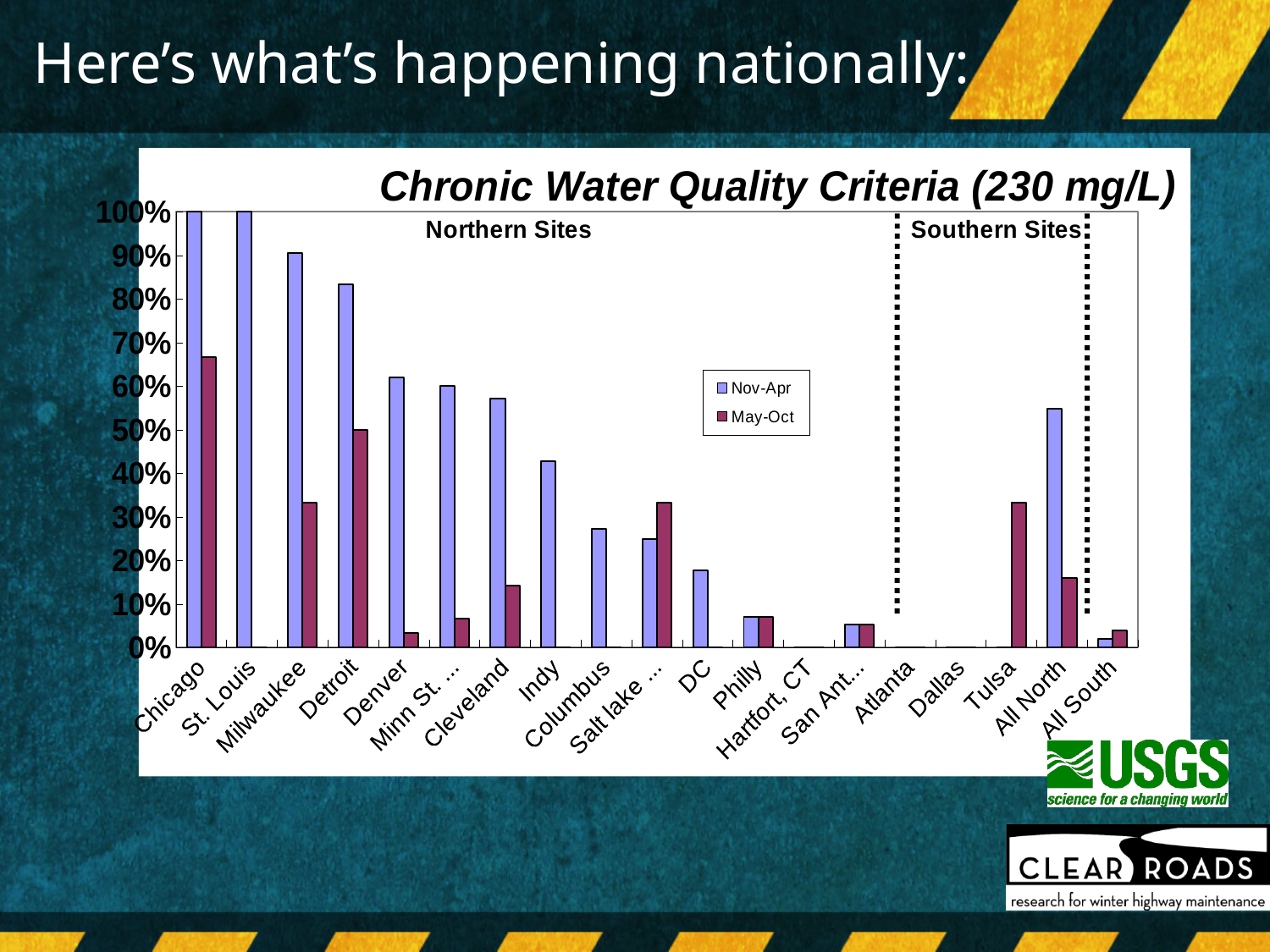
How many categories are shown along the x axis? 19 Which is larger, the May-Oct value for Chicago or the May-Oct value for Milwaukee? Chicago What kind of chart is shown on the slide? bar chart For Salt lake, which series has the larger value, Nov-Apr or May-Oct? May-Oct What is the Nov-Apr value for Chicago? 100% What are the two series named in the legend? Nov-Apr and May-Oct Which category has the highest May-Oct value? Chicago What is the title of the chart? Chronic Water Quality Criteria (230 mg/L) Is the Nov-Apr value for All North greater or less than 50%? greater Is the Nov-Apr value for Columbus greater or less than 30%? less Is the Nov-Apr value for Detroit greater or less than 80%? greater How many series does the legend list? 2